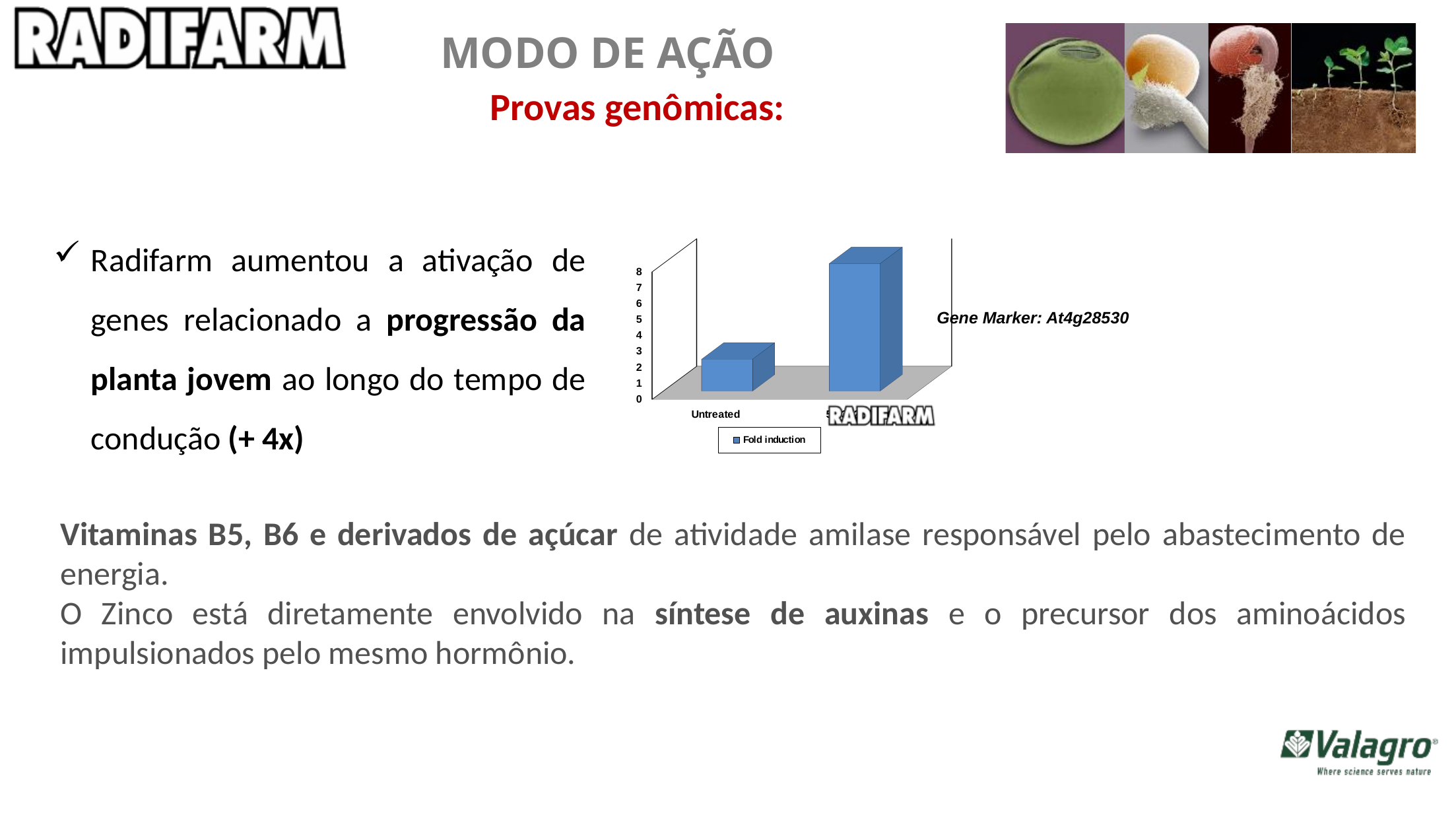
Which bar is taller, Untreated or Radifarm? Radifarm How many series does the chart legend list? 1 Is the fold induction value for Radifarm greater or less than 4? greater Do the bar values rise or fall from Untreated to Radifarm? rise Which category has the highest fold induction in the chart? Radifarm Is the fold induction value for Radifarm greater or less than 6? greater What is the name of the series shown in the chart legend? Fold induction How many bars are plotted in the chart? 2 Is the fold induction value for Untreated greater or less than 4? less What kind of chart is shown on the slide? bar chart What gene marker is named next to the chart? At4g28530 Which category has the lowest fold induction in the chart? Untreated